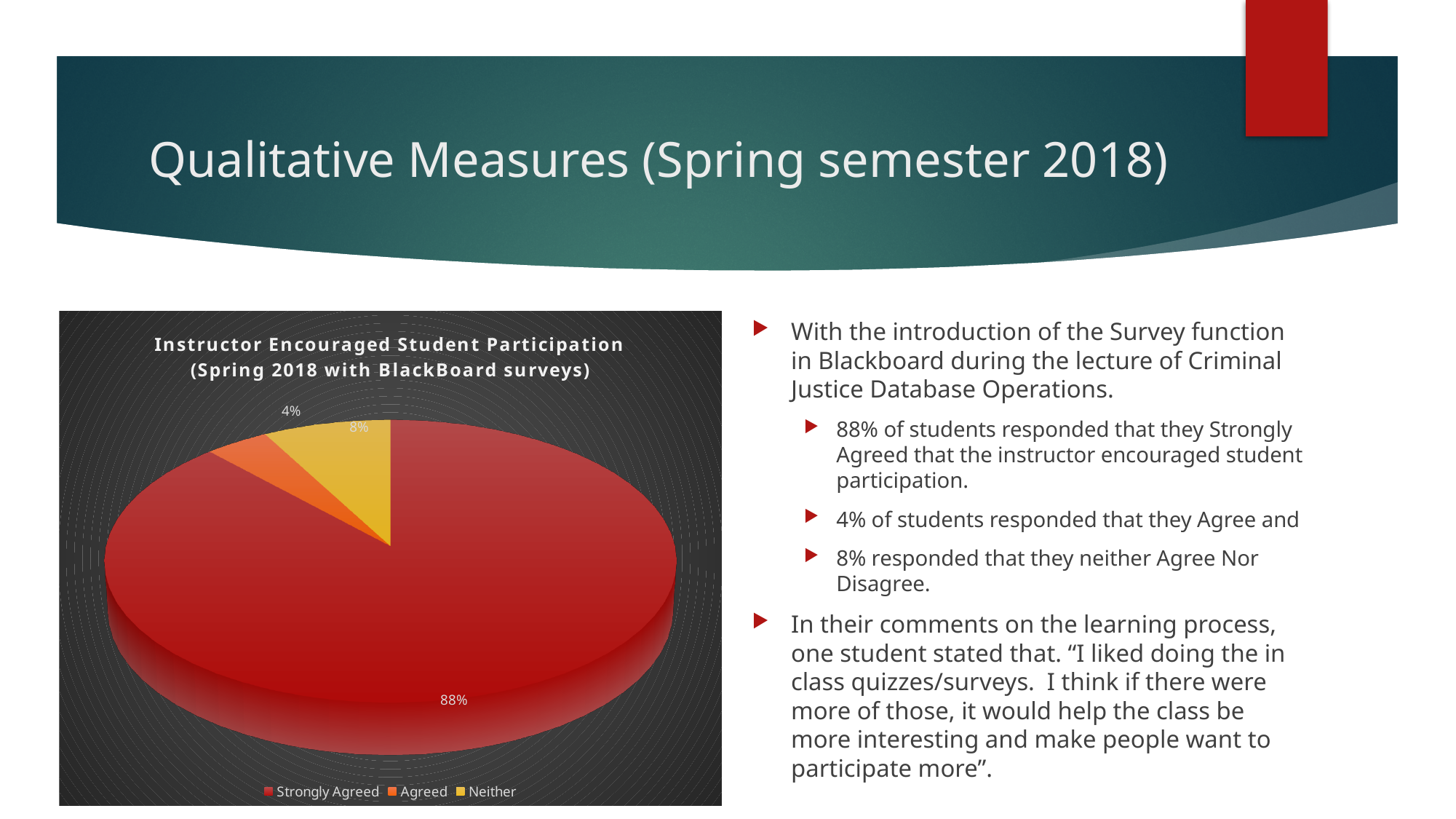
What percentage of the pie chart is labelled Agreed? 4% How many categories does the legend of the pie chart list? 3 Which slice is larger, Agreed or Neither? Neither Which category has the smallest slice of the pie chart? Agreed What colour is the Strongly Agreed slice in the pie chart? Red What kind of chart is shown on the slide? Pie chart What percentage of the pie chart is labelled Strongly Agreed? 88% What is the combined share of the Agreed and Neither slices? 12% What is the difference in percentage points between the Strongly Agreed slice and the Neither slice? 80 What percentage of the pie chart is labelled Neither? 8% What is the title of the pie chart? Instructor Encouraged Student Participation (Spring 2018 with BlackBoard surveys) Which category has the largest slice of the pie chart? Strongly Agreed